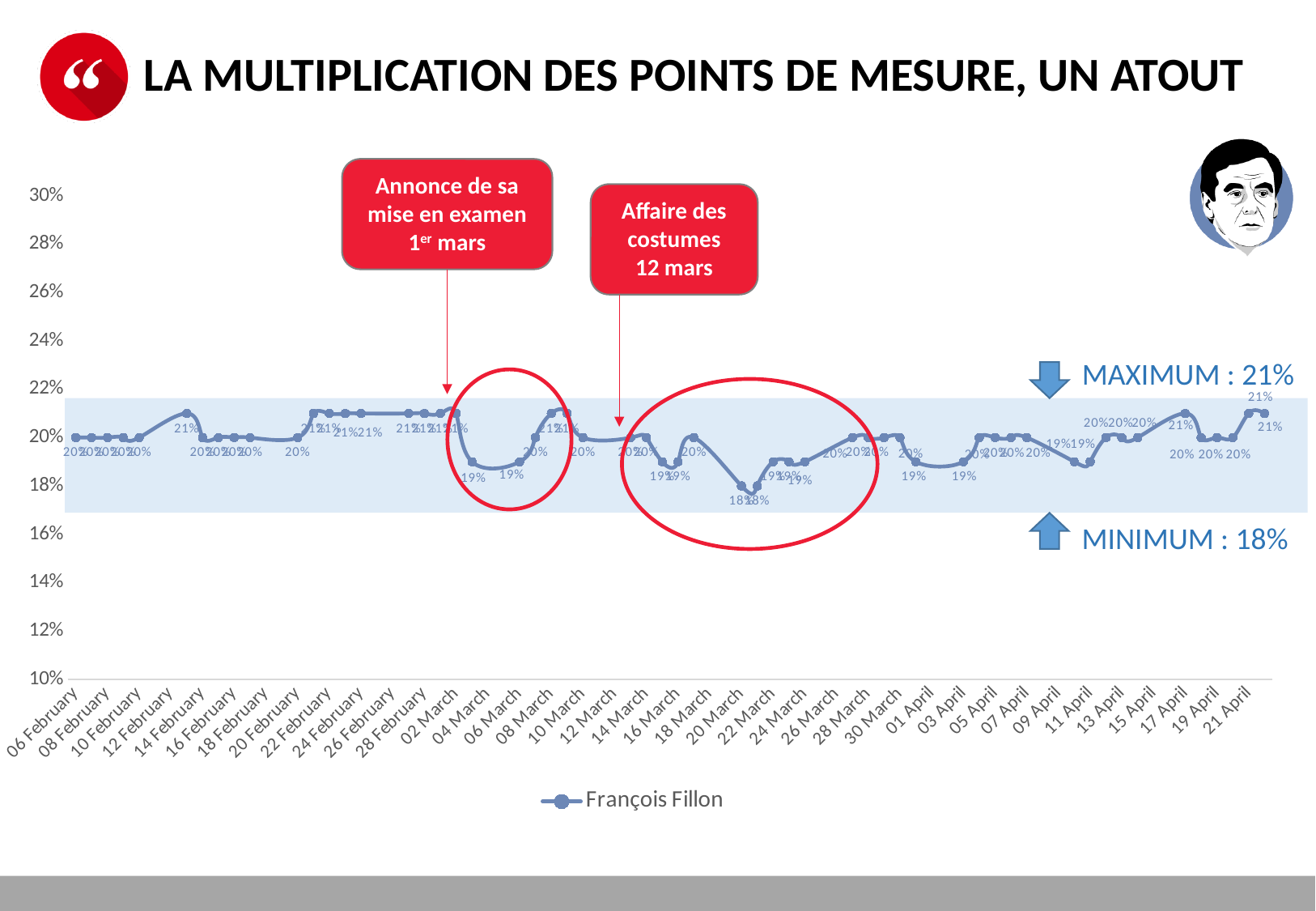
Which event does the annotation dated 12 mars refer to? Affaire des costumes What is the maximum value stated on the slide for François Fillon? 21% What is the name of the series shown in the legend? François Fillon What is the minimum value stated on the slide for François Fillon? 18% What is the value for François Fillon on 20 March? 18% How many series does the legend list? 1 What is the value for François Fillon on 21 April? 21% Is the value for François Fillon on 20 March greater or less than 20%? less What kind of chart is shown on the slide? line chart